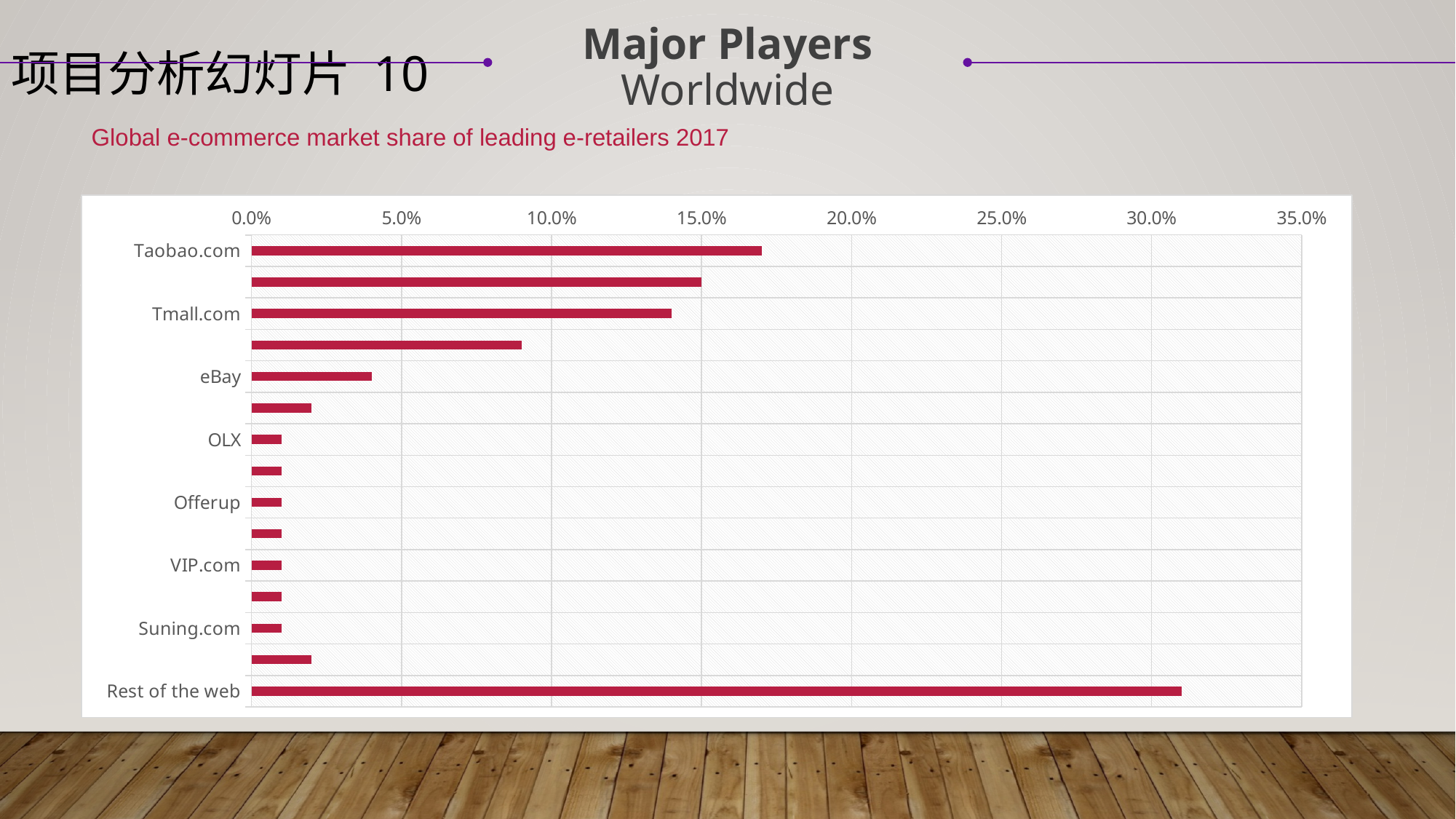
Which category has the longest bar in the chart? Rest of the web Which has the larger value, Taobao.com or Tmall.com? Taobao.com Which has the larger value, eBay or Tmall.com? Tmall.com Is the value for Tmall.com greater or less than 15.0%? less How many bars are plotted in the chart? 15 Is the value for Taobao.com greater or less than 15.0%? greater Is the value for eBay greater or less than 5.0%? less Which has the larger value, Rest of the web or Taobao.com? Rest of the web What is the highest value shown on the horizontal axis of the chart? 35.0% What kind of chart is shown on the slide? bar chart